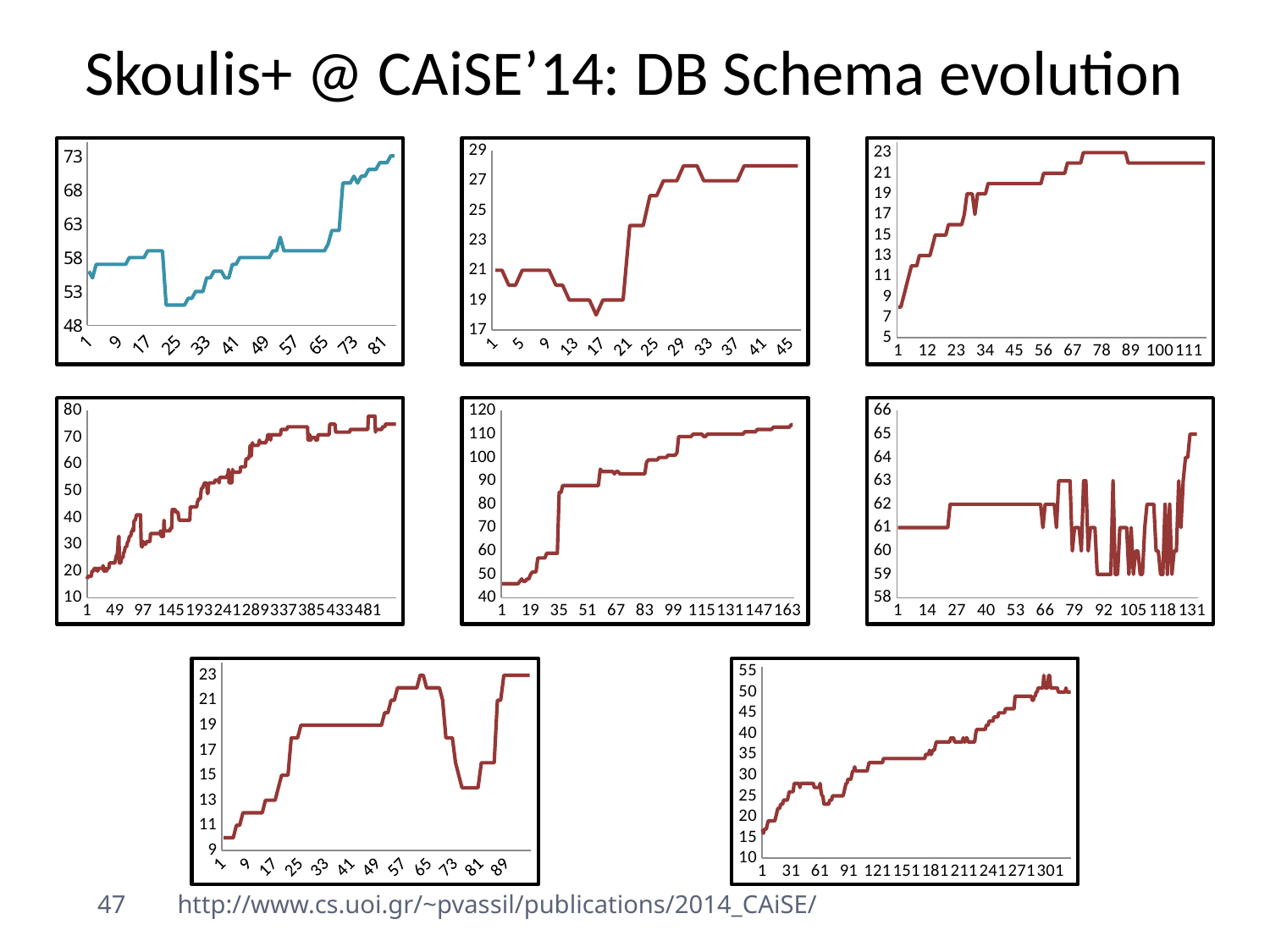
In the middle-left chart, is the value at x = 481 greater or less than 70? greater How many charts are shown on the slide? 8 In the middle-right chart, is the value at x = 131 greater or less than 64? greater In the bottom-right chart, do the values generally rise or fall from left to right along the x axis? rise In the bottom-left chart, is the value at x = 81 greater or less than 17? less What kind of chart is the top-left chart on the slide? line chart Which chart on the slide uses a blue line instead of a red one? the top-left chart In the top-left chart, do the values generally rise or fall from left to right along the x axis? rise